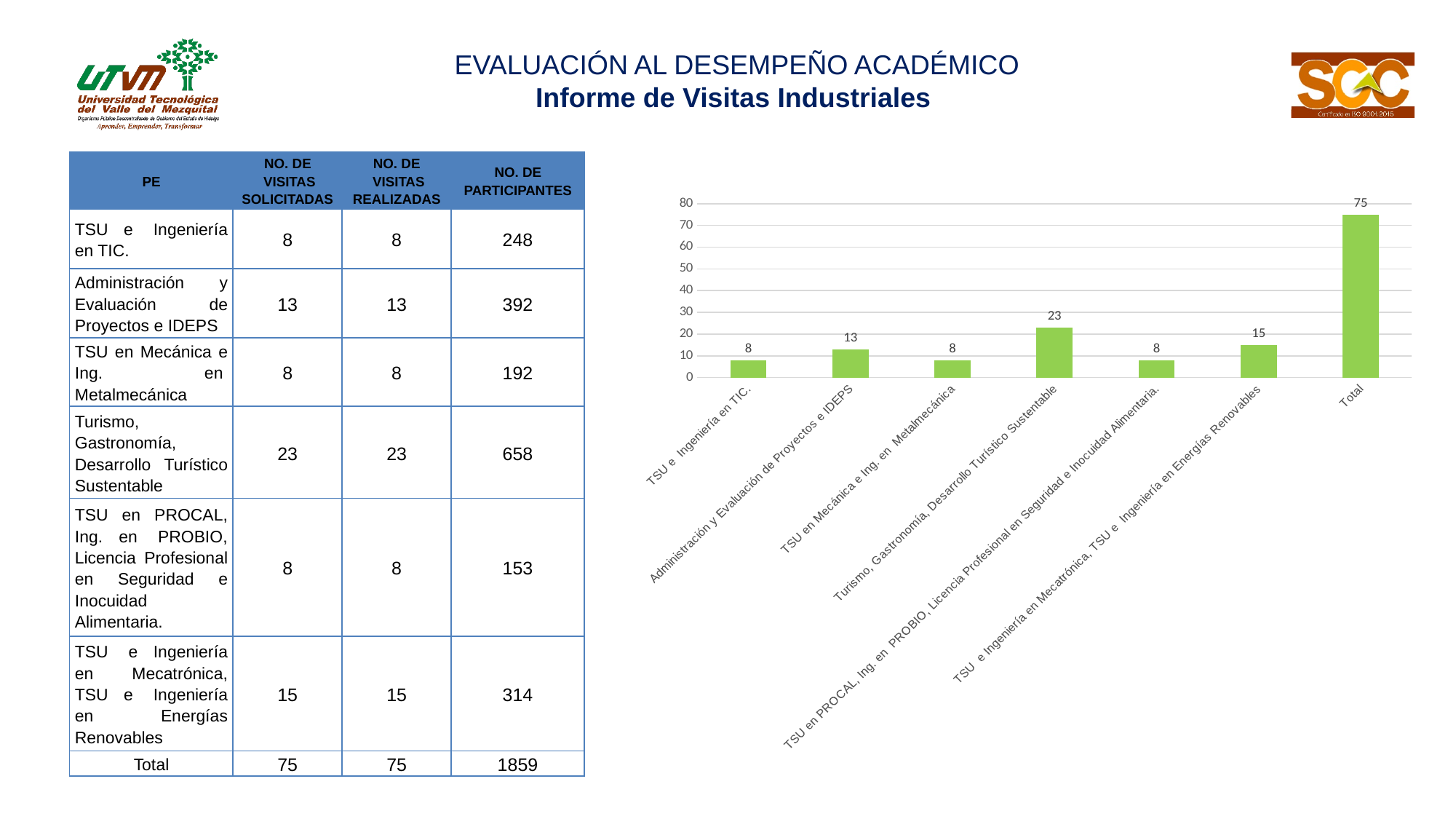
Excluding the Total bar, which category has the highest value? Turismo, Gastronomía, Desarrollo Turístico Sustentable How many bars does the chart have? 7 What is the value of the bar for TSU e Ingeniería en TIC.? 8 What is the value of the bar for Turismo, Gastronomía, Desarrollo Turístico Sustentable? 23 What is the highest value shown on the vertical axis? 80 What is the value of the bar for Administración y Evaluación de Proyectos e IDEPS? 13 What kind of chart is shown on the slide? bar chart What colour are the bars in the chart? green What is the value of the Total bar? 75 Which is larger: the bar for TSU e Ingeniería en Mecatrónica, TSU e Ingeniería en Energías Renovables or the bar for TSU en Mecánica e Ing. en Metalmecánica? TSU e Ingeniería en Mecatrónica, TSU e Ingeniería en Energías Renovables Is the value of the Total bar greater or less than 70? greater What is the difference between the Turismo, Gastronomía, Desarrollo Turístico Sustentable bar and the Administración y Evaluación de Proyectos e IDEPS bar? 10